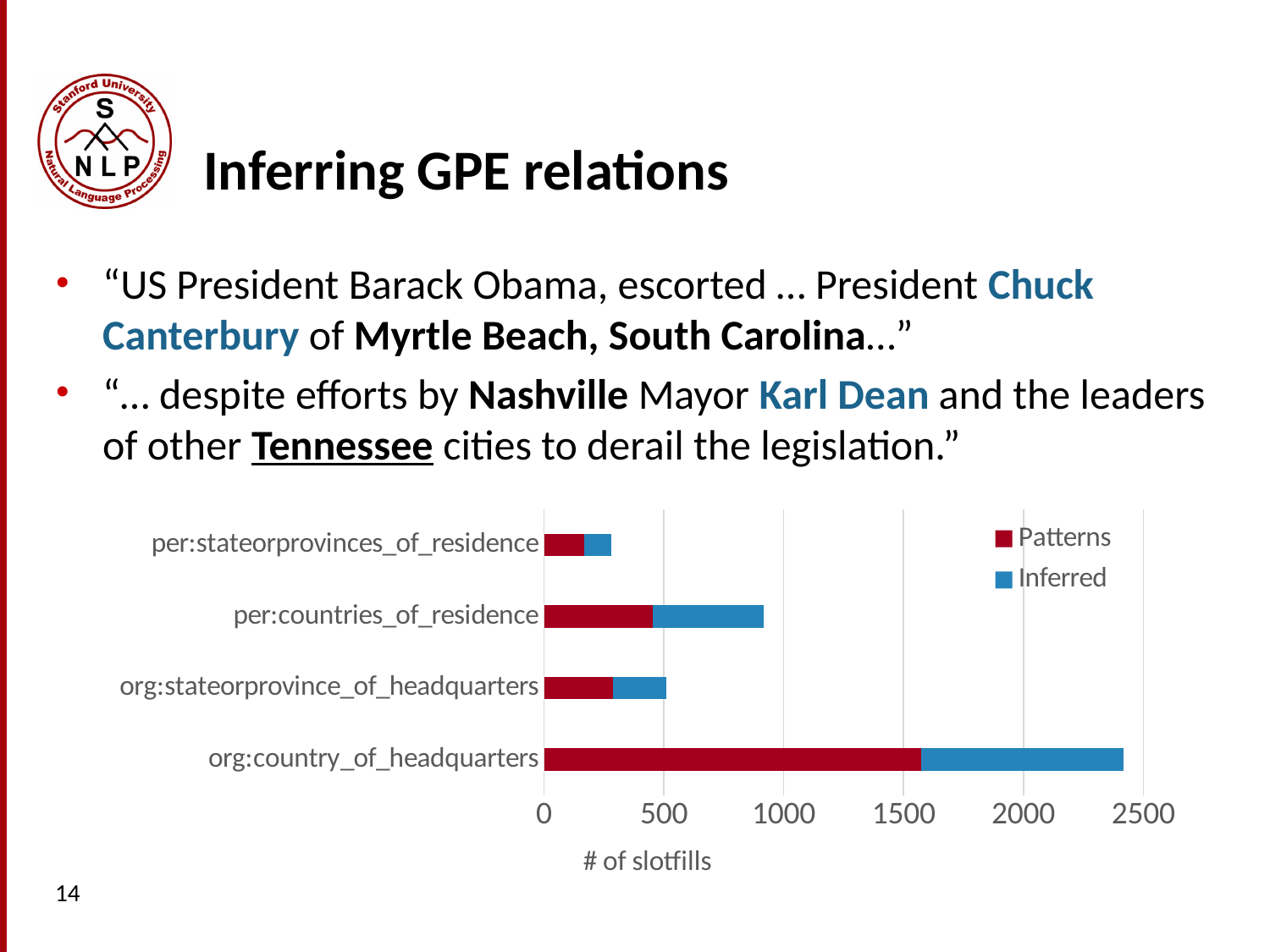
What is the label of the chart's x axis? # of slotfills Which relation has the shortest total bar in the chart? per:stateorprovinces_of_residence What kind of chart is shown on the slide? bar chart Is the total number of slotfills for per:countries_of_residence greater or less than 1000? less Is the total number of slotfills for org:country_of_headquarters greater or less than 2000? greater How many series does the chart's legend list? 2 Is the total number of slotfills for per:stateorprovinces_of_residence greater or less than 500? less How many categories (relations) are plotted in the chart? 4 Which has a longer total bar: per:countries_of_residence or org:stateorprovince_of_headquarters? per:countries_of_residence Which relation has the longest total bar in the chart? org:country_of_headquarters Which series is shown in red in the chart? Patterns